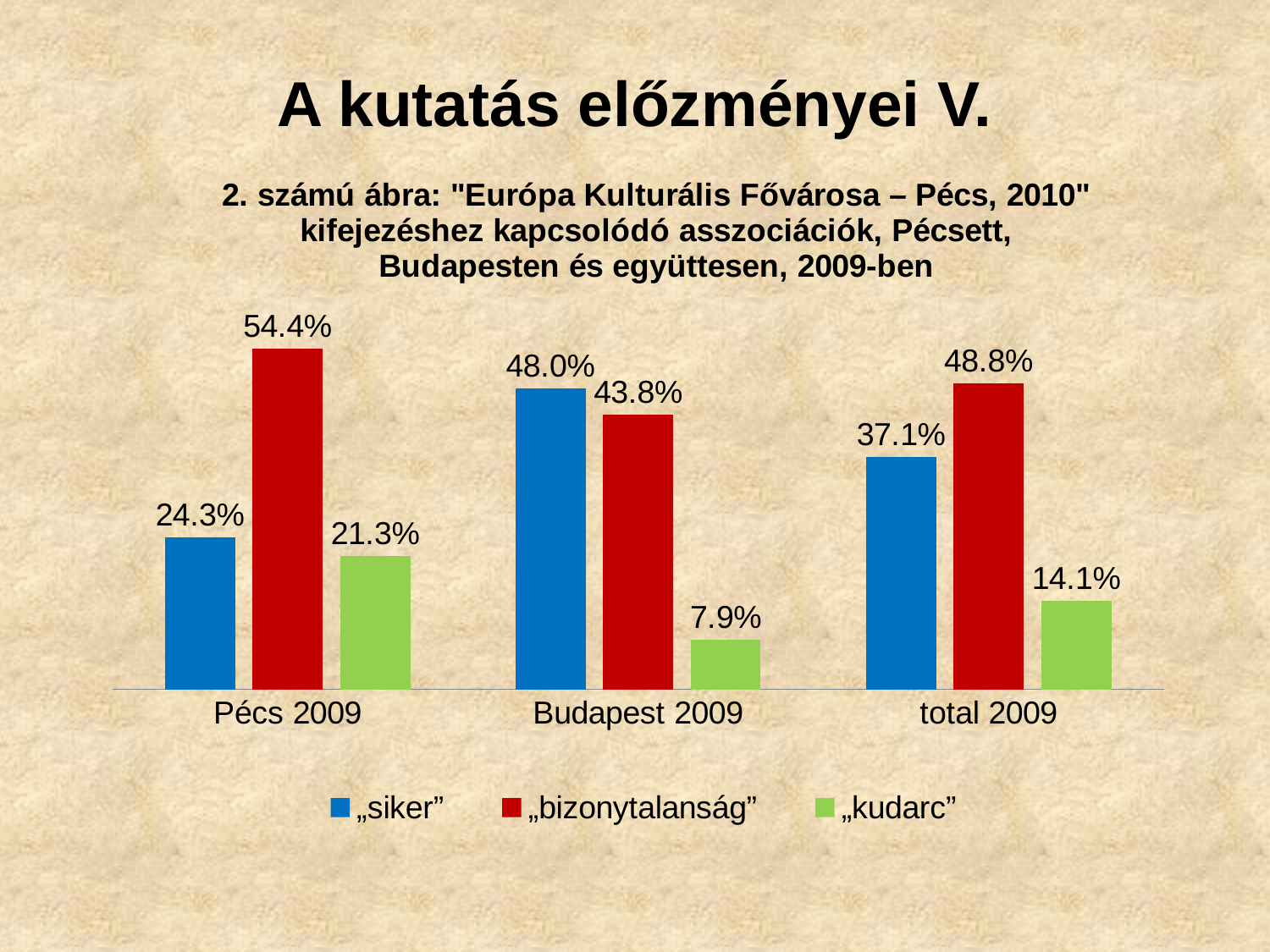
What is the value for "bizonytalanság" in Budapest 2009? 43.8% How many series does the legend list? 3 What is the value for "kudarc" in total 2009? 14.1% Which is larger in Budapest 2009: "siker" or "bizonytalanság"? "siker" Which colour represents the "kudarc" series? Green How many categories are shown on the x axis? 3 What is the difference between the "siker" values for Budapest 2009 and Pécs 2009? 23.7% What is the value for "siker" in Pécs 2009? 24.3% Which category has the highest value for "bizonytalanság"? Pécs 2009 Which category has the lowest value for "kudarc"? Budapest 2009 What is the difference between "bizonytalanság" and "kudarc" in total 2009? 34.7% What kind of chart is shown on the slide? Bar chart